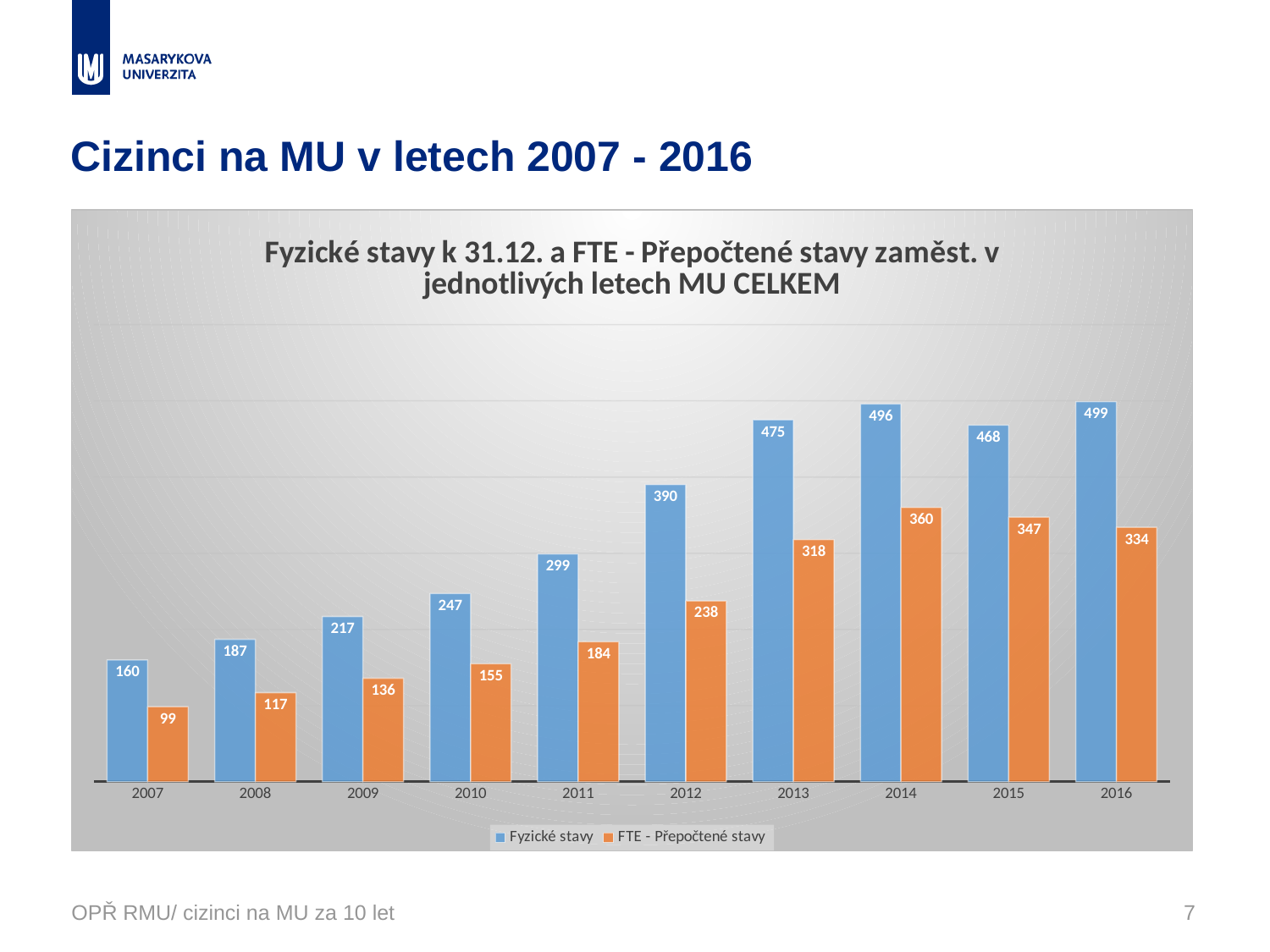
What is the difference between Fyzické stavy and FTE - Přepočtené stavy in 2014? 136 What kind of chart is shown on the slide? bar chart How many years are shown on the x axis? 10 Which is larger: FTE - Přepočtené stavy in 2015 or FTE - Přepočtené stavy in 2016? 2015 What is the value of Fyzické stavy for 2012? 390 How many series does the legend list? 2 Which is larger: Fyzické stavy in 2013 or Fyzické stavy in 2015? 2013 Does FTE - Přepočtené stavy rise or fall from 2007 to 2014? rise Which year has the highest value for Fyzické stavy? 2016 What is the difference between Fyzické stavy in 2016 and Fyzické stavy in 2007? 339 What is the value of FTE - Přepočtené stavy for 2009? 136 Which year has the lowest value for FTE - Přepočtené stavy? 2007